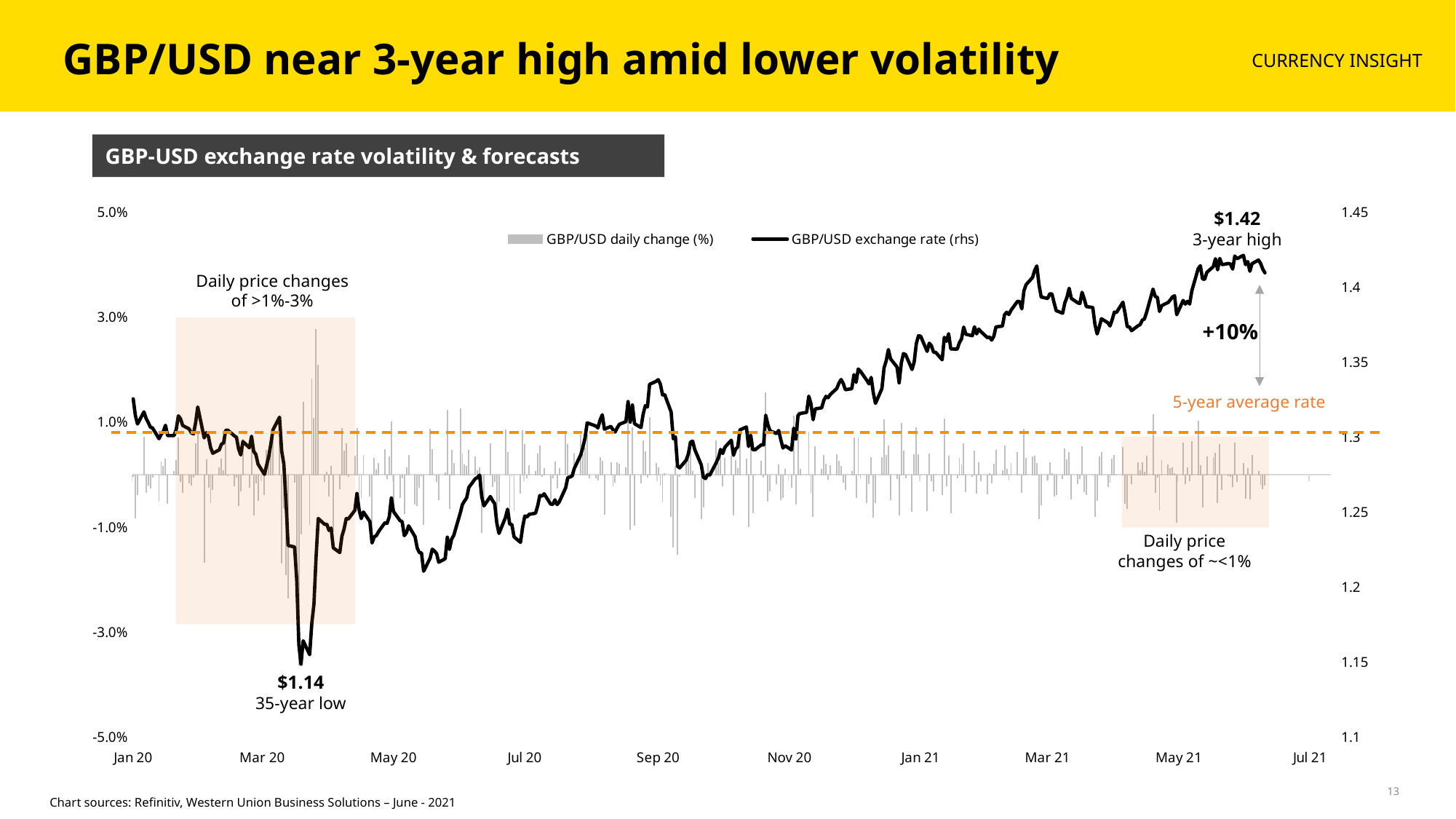
What percentage change is annotated between the 5-year average rate and the 3-year high? +10% How many series does the chart's legend list? 2 What value is labelled as the 35-year low for the GBP/USD exchange rate? $1.14 What does the dashed orange horizontal line on the chart represent? 5-year average rate What value is labelled as the 3-year high for the GBP/USD exchange rate? $1.42 Is the GBP/USD exchange rate higher in May 20 or in May 21? May 21 Is the lowest point of the GBP/USD exchange rate line in Mar 20 greater or less than 1.2 on the right-hand axis? less What kind of chart is shown on the slide? Combined bar and line chart What is the difference between the labelled 3-year high and the labelled 35-year low of the GBP/USD exchange rate? $0.28 Is the GBP/USD exchange rate in Jan 21 greater or less than 1.3 on the right-hand axis? greater What is the title of the chart on the slide? GBP-USD exchange rate volatility & forecasts Does the GBP/USD exchange rate line rise or fall between Sep 20 and Mar 21? Rise